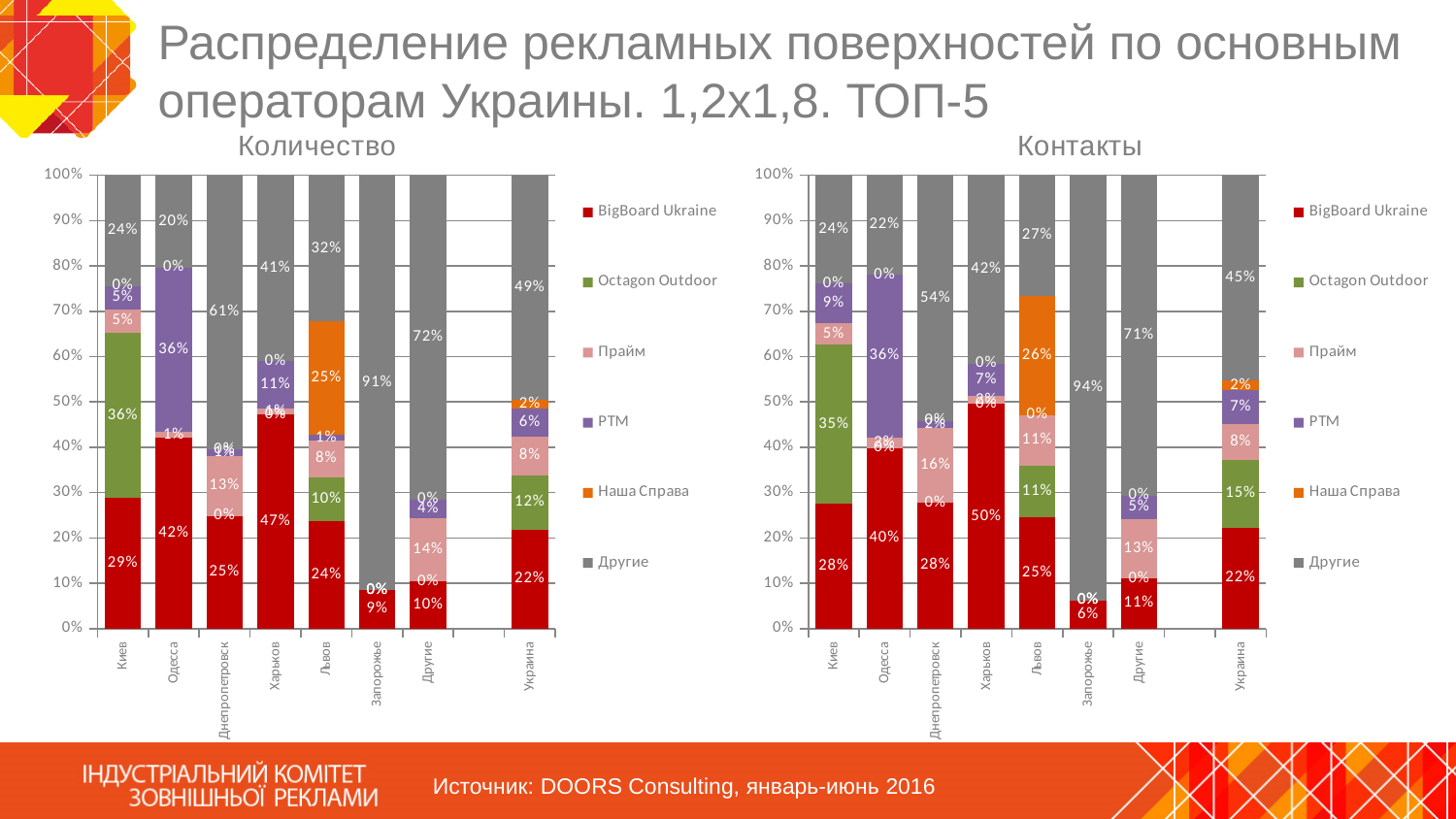
On the right chart titled "Контакты", what is the value for Наша Справа in Львов? 26% On the right chart titled "Контакты", which category has the lowest BigBoard Ukraine share? Запорожье On the left chart titled "Количество", which city has the highest BigBoard Ukraine share? Харьков On the left chart titled "Количество", what is the value for Другие (the grey series) in Запорожье? 91% On the right chart titled "Контакты", which is larger: the Другие (grey) value for Днепропетровск or for Харьков? Днепропетровск On the right chart titled "Контакты", what is the value for Octagon Outdoor in Украина? 15% What type of chart is the left chart titled "Количество"? Stacked bar chart How many series does the legend of the right chart titled "Контакты" list? 6 On the left chart titled "Количество", what is the difference between the BigBoard Ukraine values for Одесса and Киев? 13% How many categories are shown on the x axis of the left chart titled "Количество"? 8 On the right chart titled "Контакты", what is the value for BigBoard Ukraine in Одесса? 40% On the left chart titled "Количество", what is the value for BigBoard Ukraine in Харьков? 47%